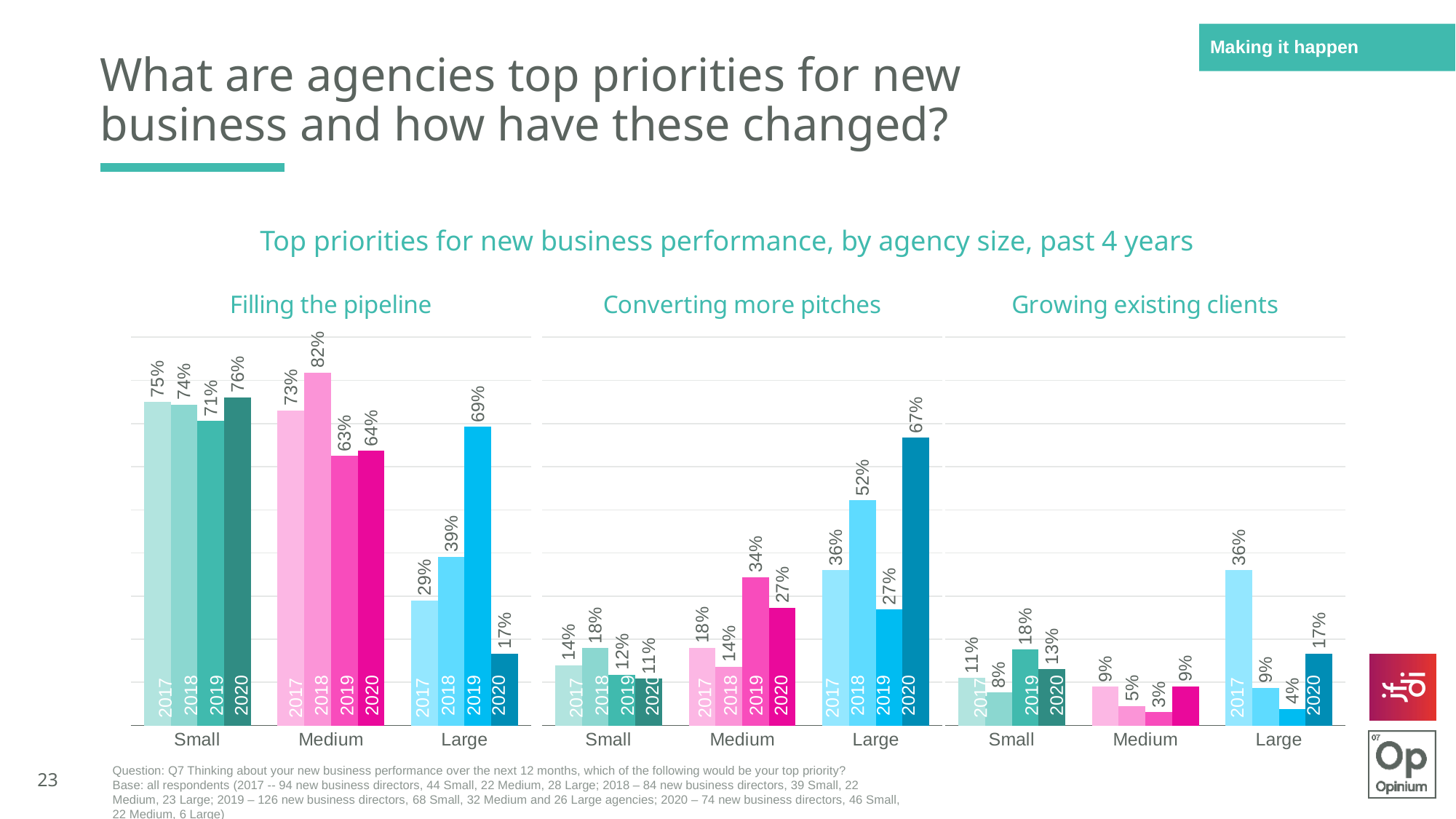
In the 'Converting more pitches' chart, do the Large agency values rise or fall from 2019 to 2020? Rise In the 'Converting more pitches' chart, what is the value for Large agencies in 2020? 67% In the 'Converting more pitches' chart, which year has the highest value for Medium agencies? 2019 In the 'Growing existing clients' chart, which year has the lowest value for Large agencies? 2019 In the 'Filling the pipeline' chart, what is the value for Large agencies in 2020? 17% In the 'Growing existing clients' chart, how many agency size categories are shown on the x axis? 3 In the 'Filling the pipeline' chart, what is the value for Medium agencies in 2018? 82% In the 'Growing existing clients' chart, what is the value for Large agencies in 2017? 36% In the 'Filling the pipeline' chart, what is the difference between the Large agency values for 2019 and 2020? 52% How many years are shown for each agency size in the 'Filling the pipeline' chart? 4 In the 'Converting more pitches' chart, which is larger: the Small agency value for 2018 or the Small agency value for 2019? 2018 What type of chart is used for 'Converting more pitches'? Bar chart